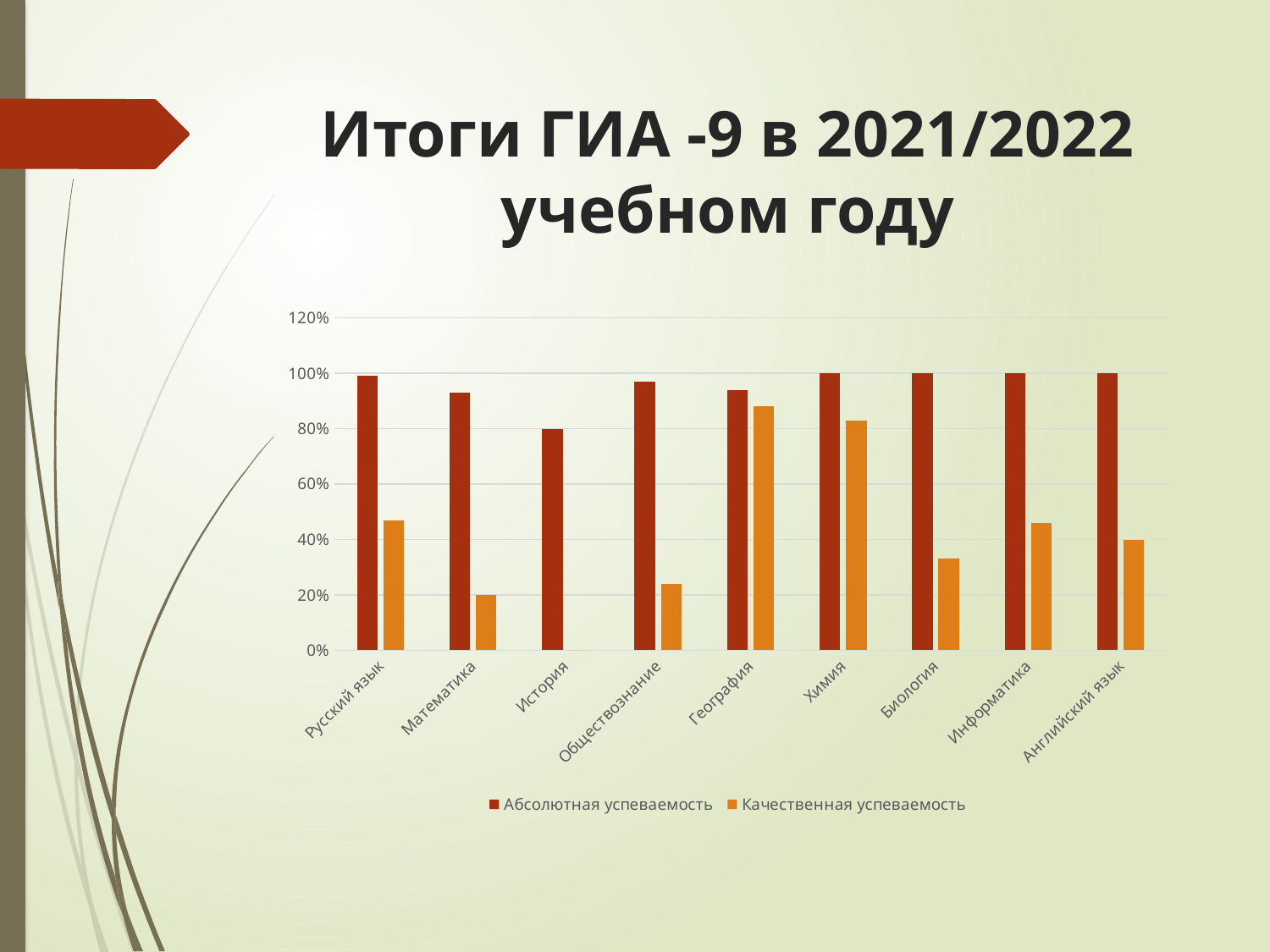
How many subject categories are shown on the x axis? 9 Is the Качественная успеваемость value for Русский язык greater or less than 40%? greater What kind of chart is shown on the slide? bar chart Which subject has the highest Качественная успеваемость? География What is the Абсолютная успеваемость value for История? 80% What is the Качественная успеваемость value for Математика? 20% How many series does the legend list? 2 Which series is shown in orange in the legend? Качественная успеваемость Which is larger: the Качественная успеваемость for Русский язык or for Математика? Русский язык Is the Качественная успеваемость value for Биология greater or less than 40%? less What is the Качественная успеваемость value for Английский язык? 40% Which subject has the lowest Абсолютная успеваемость? История